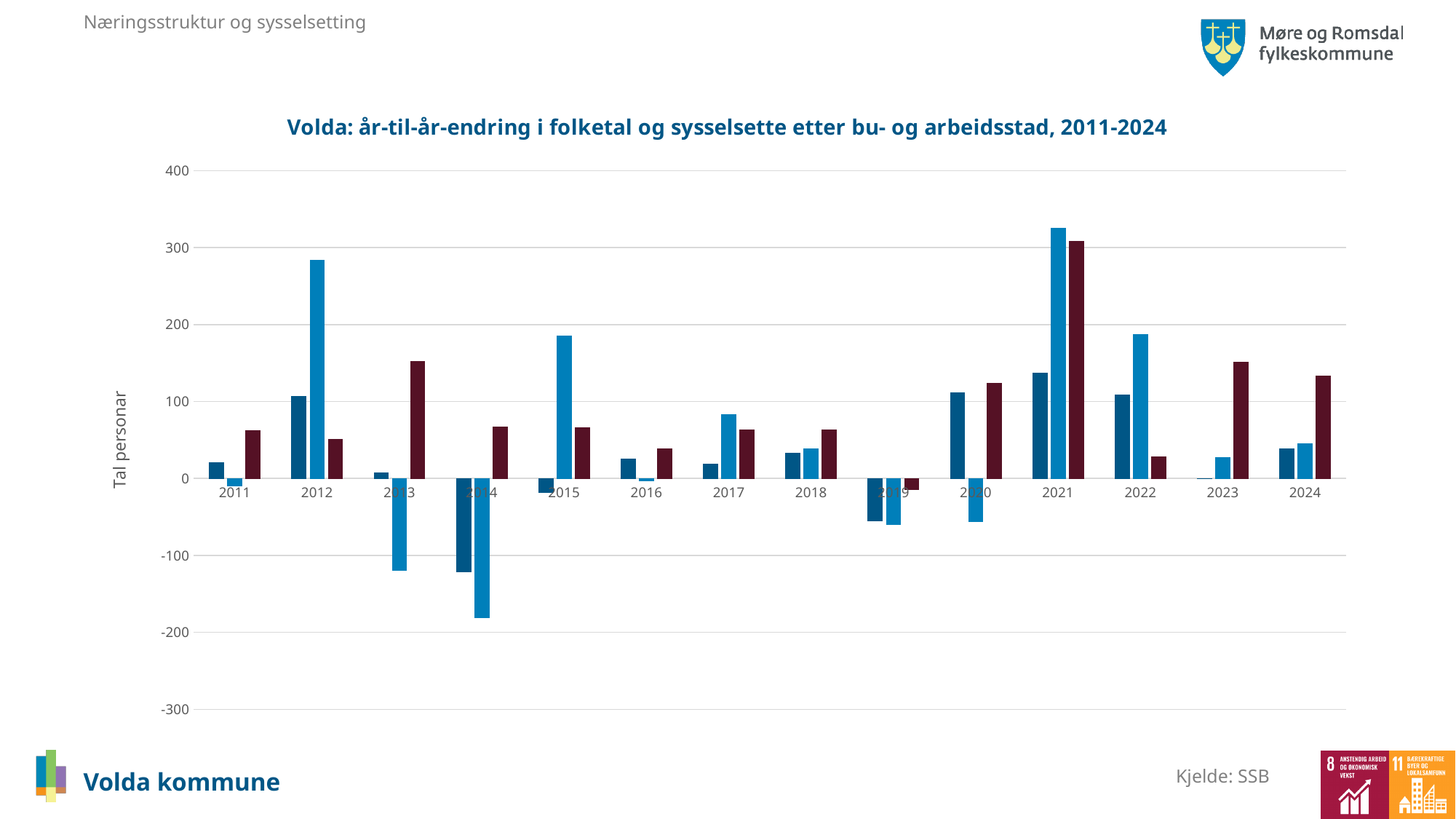
What is the label on the vertical axis of the chart? Tal personar What kind of chart is shown on the slide? bar chart Is the dark red bar for 2023 greater or less than 100? greater What is the title of the chart? Volda: år-til-år-endring i folketal og sysselsette etter bu- og arbeidsstad, 2011-2024 Which is larger, the light blue bar for 2012 or the light blue bar for 2015? 2012 Which is larger, the dark red bar for 2021 or the dark red bar for 2024? 2021 How many bars are plotted for each year in the chart? 3 How many years are shown along the x axis of the chart? 14 In which year is the light blue bar the highest? 2021 Is the light blue bar for 2012 greater or less than 200? greater In which year is the light blue bar the lowest? 2014 Is the light blue bar for 2014 greater or less than -100? less